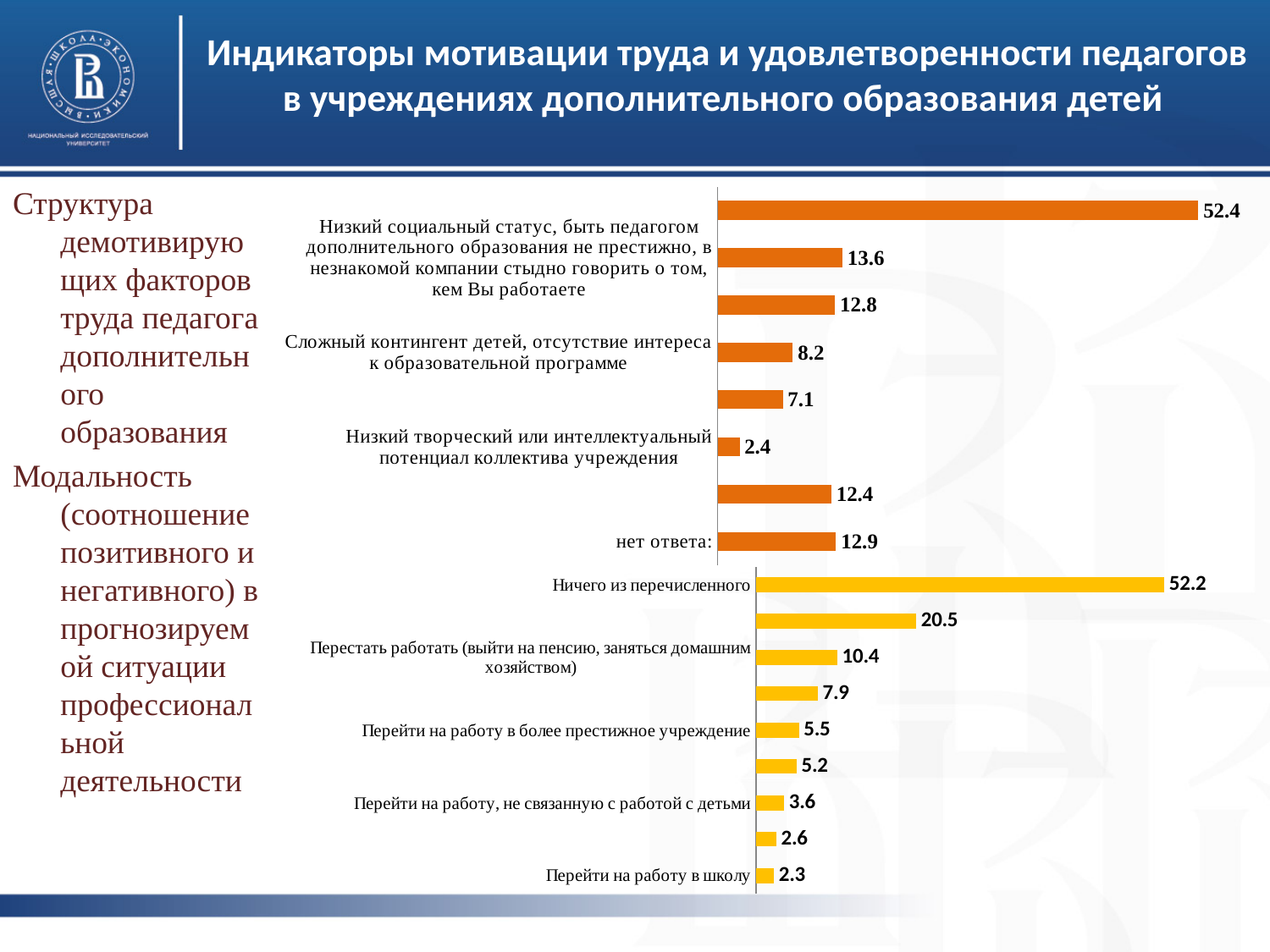
In the top (orange) chart, what is the value for 'Низкий творческий или интеллектуальный потенциал коллектива учреждения'? 2.4 In the top (orange) chart, what is the value for 'Сложный контингент детей, отсутствие интереса к образовательной программе'? 8.2 What type of chart is the top (orange) chart? Bar chart In the top (orange) chart, what is the value for 'нет ответа'? 12.9 In the bottom (yellow) chart, what is the value for 'Перейти на работу в школу'? 2.3 How many bars does the bottom (yellow) chart have? 9 In the bottom (yellow) chart, what is the value for 'Перейти на работу в более престижное учреждение'? 5.5 In the top (orange) chart, what is the highest value shown? 52.4 In the bottom (yellow) chart, what is the value for 'Ничего из перечисленного'? 52.2 In the top (orange) chart, what is the lowest value shown? 2.4 In the bottom (yellow) chart, what is the difference between 'Перестать работать (выйти на пенсию, заняться домашним хозяйством)' and 'Перейти на работу, не связанную с работой с детьми'? 6.8 In the bottom (yellow) chart, which is larger: 'Перейти на работу в более престижное учреждение' or 'Перейти на работу в школу'? Перейти на работу в более престижное учреждение